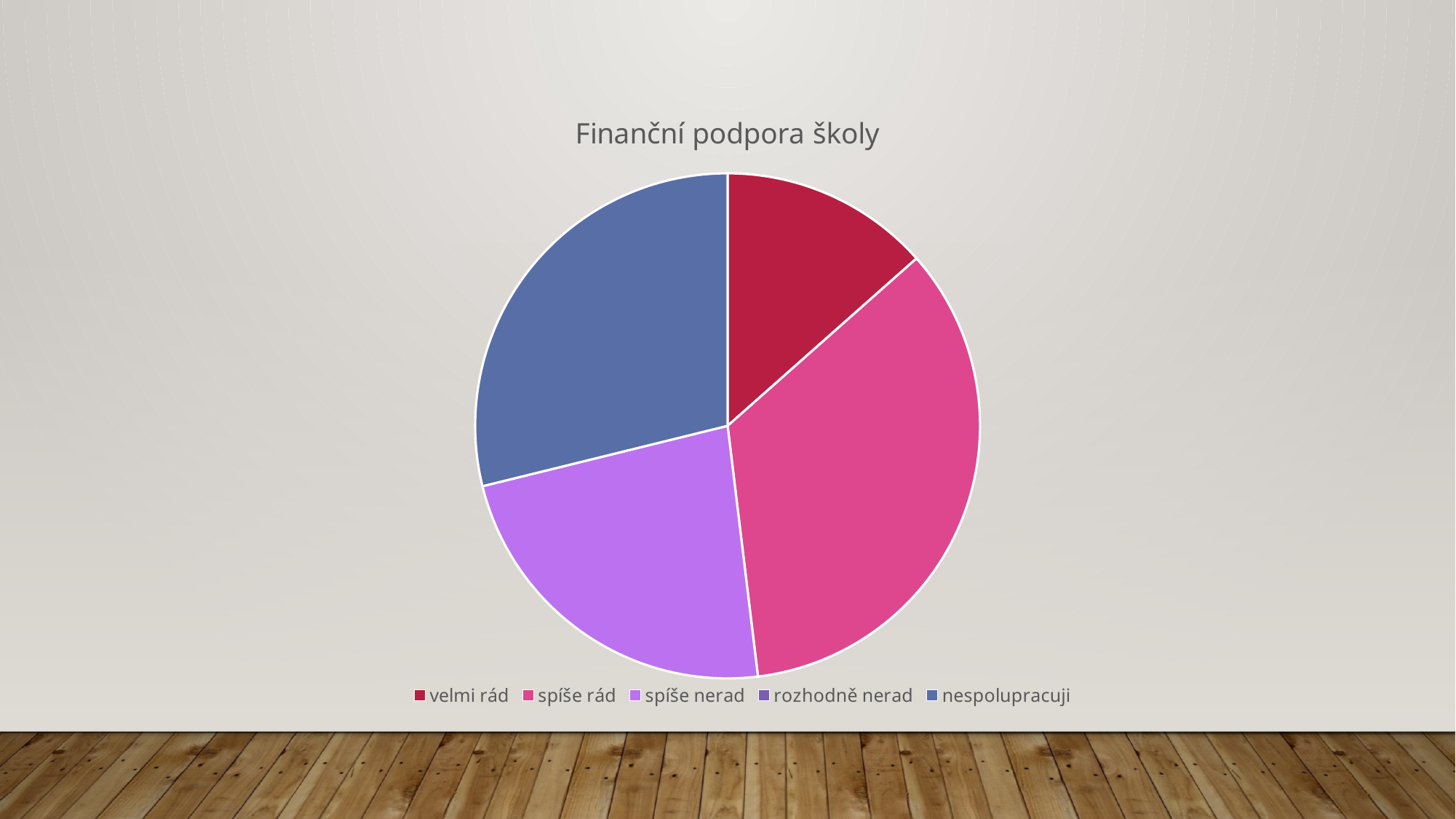
Which category has the largest slice of the pie? spíše rád What is the title of the chart? Finanční podpora školy How many slices are visible in the pie? 4 Which slice is larger, spíše rád or nespolupracuji? spíše rád Which legend entry has no visible slice in the pie? rozhodně nerad Which slice is larger, velmi rád or nespolupracuji? nespolupracuji How many entries does the chart's legend list? 5 Which slice is larger, spíše nerad or nespolupracuji? nespolupracuji What kind of chart is shown on the slide? pie chart